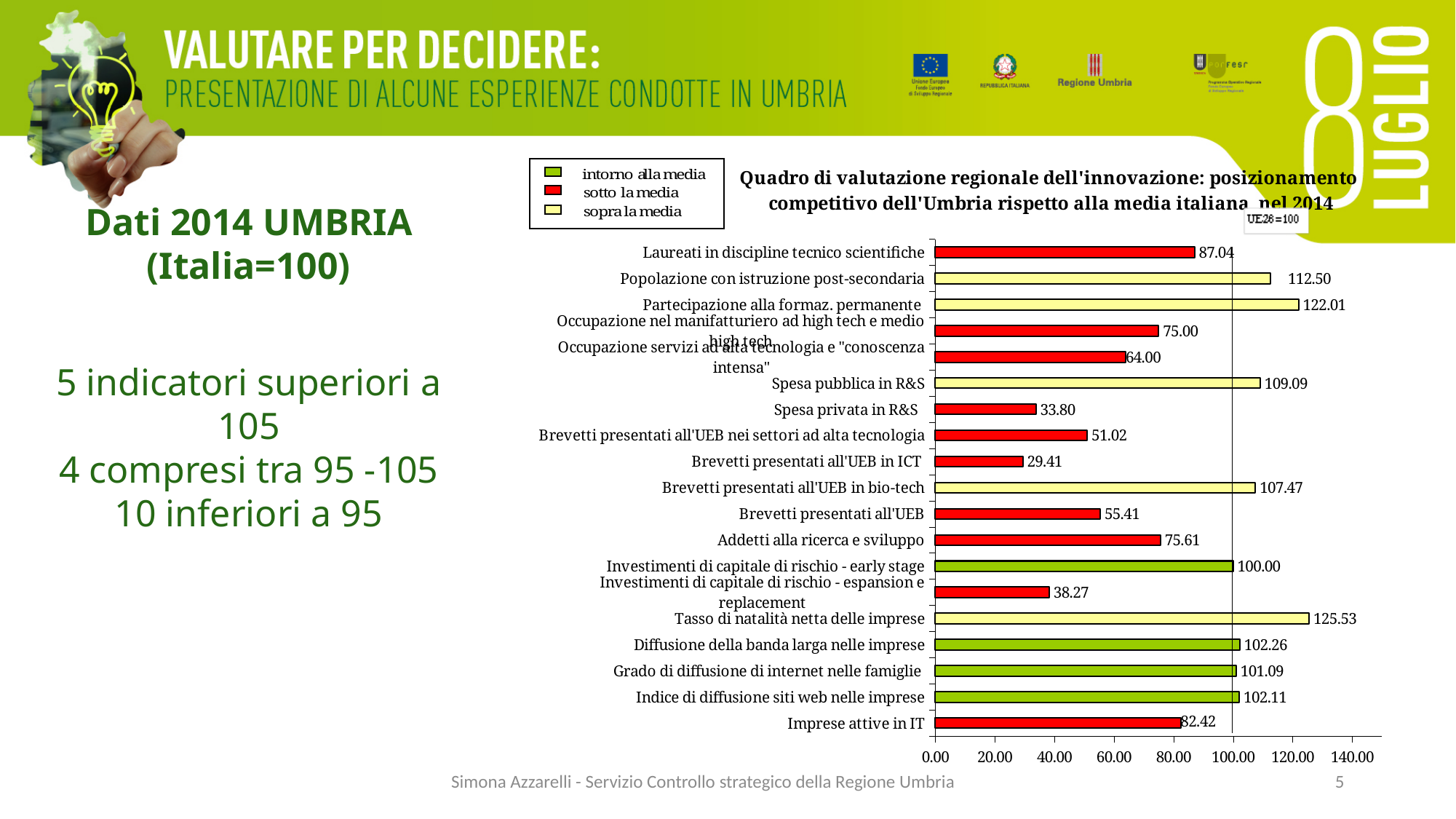
Which indicator has the lowest value? Brevetti presentati all'UEB in ICT Which indicator has the highest value? Tasso di natalità netta delle imprese What kind of chart is shown? Bar chart What is the value for Tasso di natalità netta delle imprese? 125.53 What is the difference between Partecipazione alla formaz. permanente and Laureati in discipline tecnico scientifiche? 34.97 Which is larger, Spesa pubblica in R&S or Spesa privata in R&S? Spesa pubblica in R&S Is the value for Imprese attive in IT greater or less than 100.00? less What is the value for Spesa privata in R&S? 33.80 How many entries does the legend list? 3 Which legend entry is shown in red? sotto la media How many indicators are plotted in the chart? 19 What is the value for Brevetti presentati all'UEB in bio-tech? 107.47